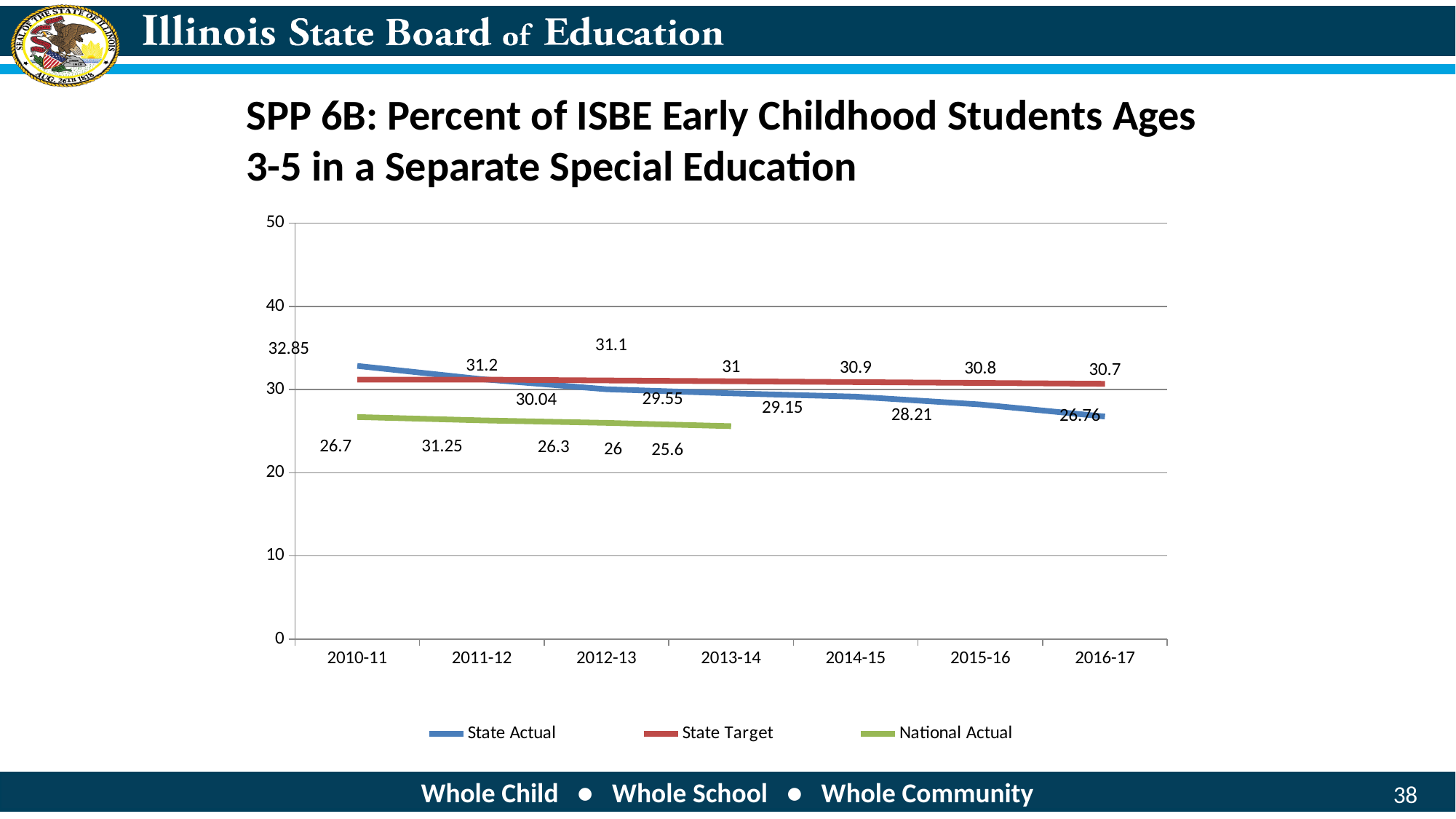
Is the State Actual value for 2016-17 greater or less than 30? less What is the State Actual value for 2016-17? 26.76 How many school years are shown on the x axis? 7 What is the National Actual value for 2013-14? 25.6 What kind of chart is shown on the slide? line chart What is the difference between the State Target and State Actual values in 2016-17? 3.94 How many series does the legend list? 3 In which year is the State Actual value lowest? 2016-17 In 2016-17, which is larger: State Actual or State Target? State Target What is the State Actual value for 2015-16? 28.21 What is the State Target value for 2016-17? 30.7 Does the State Actual line rise or fall from 2010-11 to 2016-17? fall